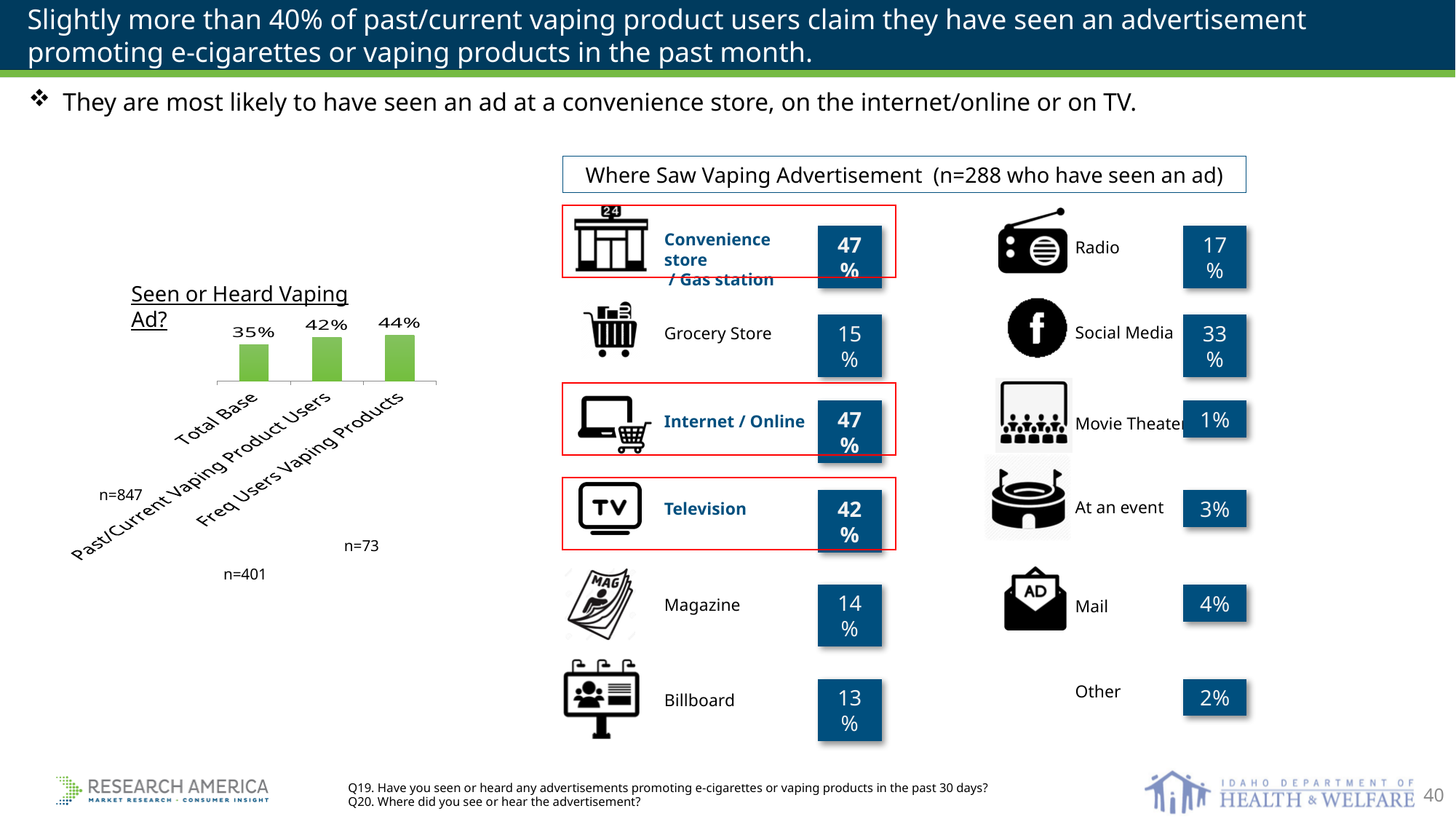
In the 'Seen or Heard Vaping Ad?' chart, what is the value for Total Base? 35% How many categories are shown in the 'Seen or Heard Vaping Ad?' chart? 3 In the 'Seen or Heard Vaping Ad?' chart, do the values rise or fall from left to right? rise In the 'Where Saw Vaping Advertisement' display, what percentage saw an ad on Television? 42% In the 'Seen or Heard Vaping Ad?' chart, what is the value for Past/Current Vaping Product Users? 42% In the 'Seen or Heard Vaping Ad?' chart, which is larger: Total Base or Past/Current Vaping Product Users? Past/Current Vaping Product Users In the 'Where Saw Vaping Advertisement' display, what is the difference between Social Media and Radio? 16% What type of chart is the 'Seen or Heard Vaping Ad?' chart? bar chart In the 'Seen or Heard Vaping Ad?' chart, which category has the lowest value? Total Base In the 'Seen or Heard Vaping Ad?' chart, what is the difference between Freq Users Vaping Products and Total Base? 9% In the 'Seen or Heard Vaping Ad?' chart, which category has the highest value? Freq Users Vaping Products In the 'Seen or Heard Vaping Ad?' chart, what is the value for Freq Users Vaping Products? 44%